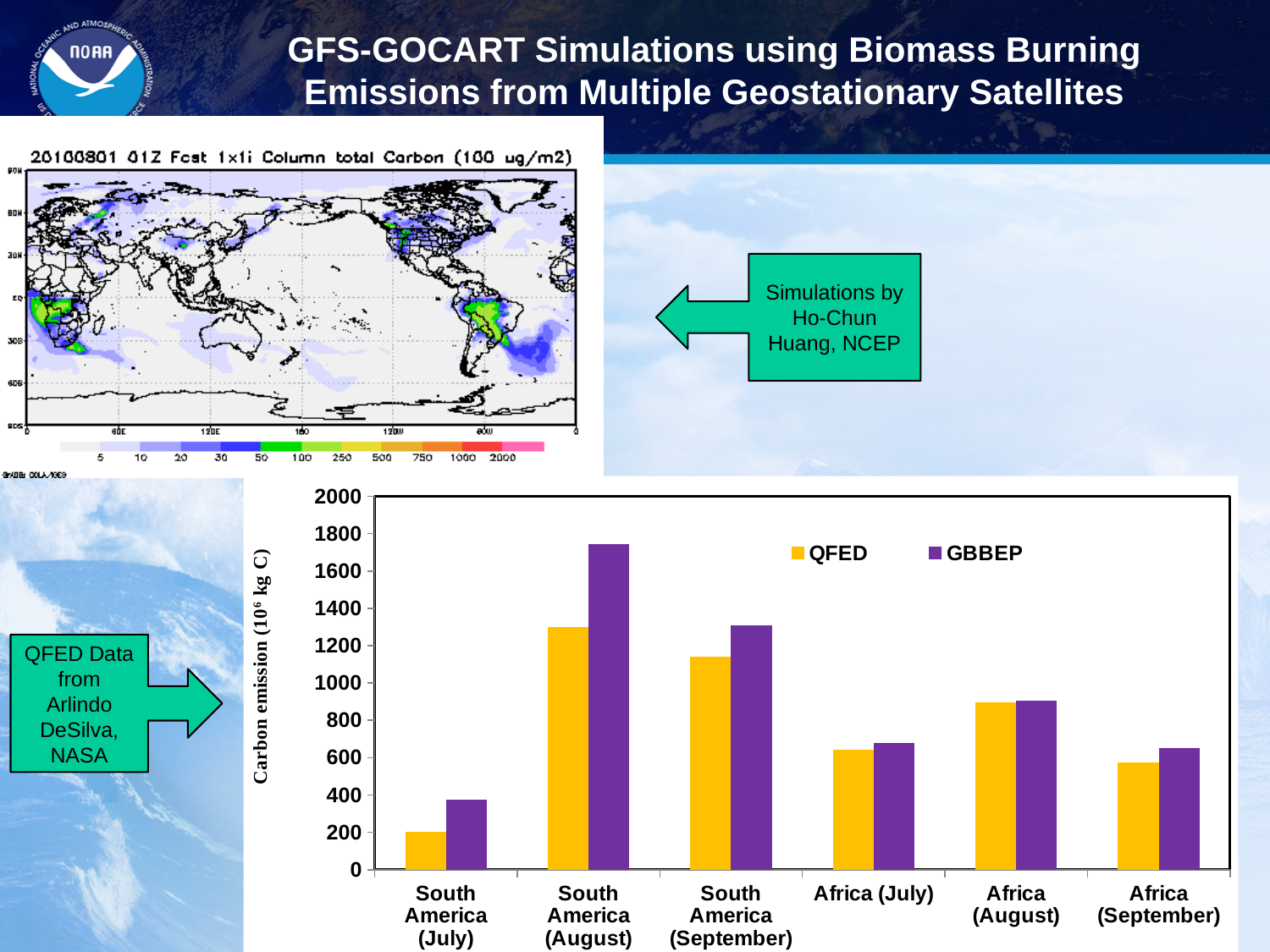
In the bar chart, which category has the highest QFED carbon emission? South America (August) In the bar chart, for South America (August), which series shows the larger carbon emission, QFED or GBBEP? GBBEP How many region/month categories are shown on the x axis of the bar chart? 6 How many series does the legend of the bar chart list? 2 What kind of chart is shown at the bottom of the slide? Bar chart In the bar chart, is the GBBEP value for South America (August) greater or less than 1600? greater What is the y-axis label of the bar chart? Carbon emission (10^6 kg C) In the bar chart, for Africa (September), which series shows the larger carbon emission, QFED or GBBEP? GBBEP In the bar chart, is the QFED value for South America (September) greater or less than 1000? greater In the bar chart, is the QFED value for South America (July) greater or less than 400? less In the bar chart, which category has the lowest QFED carbon emission? South America (July) In the bar chart, which category has the highest GBBEP carbon emission? South America (August)